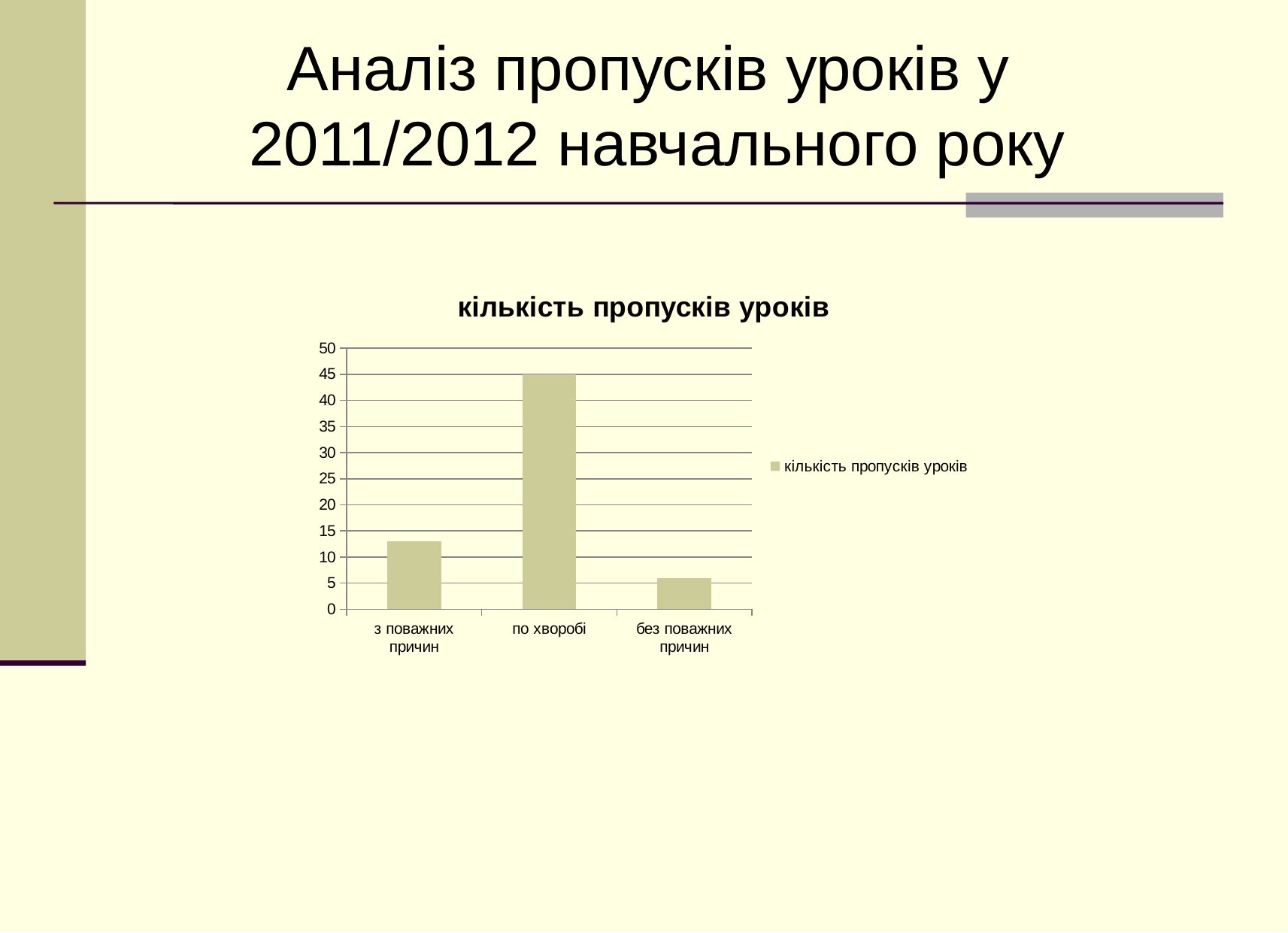
Which is larger, the value for "з поважних причин" or the value for "без поважних причин"? з поважних причин Is the value for "з поважних причин" greater or less than 15? less How many categories are shown on the x axis of the chart? 3 Is the value for "без поважних причин" greater or less than 10? less What is the value for "по хворобі"? 45 What is the title of the chart? кількість пропусків уроків What kind of chart is shown on the slide? bar chart Which category has the lowest value? без поважних причин Which category has the highest value? по хворобі How many series does the legend list? 1 What is the name of the series shown in the legend? кількість пропусків уроків Is the value for "з поважних причин" greater or less than 10? greater